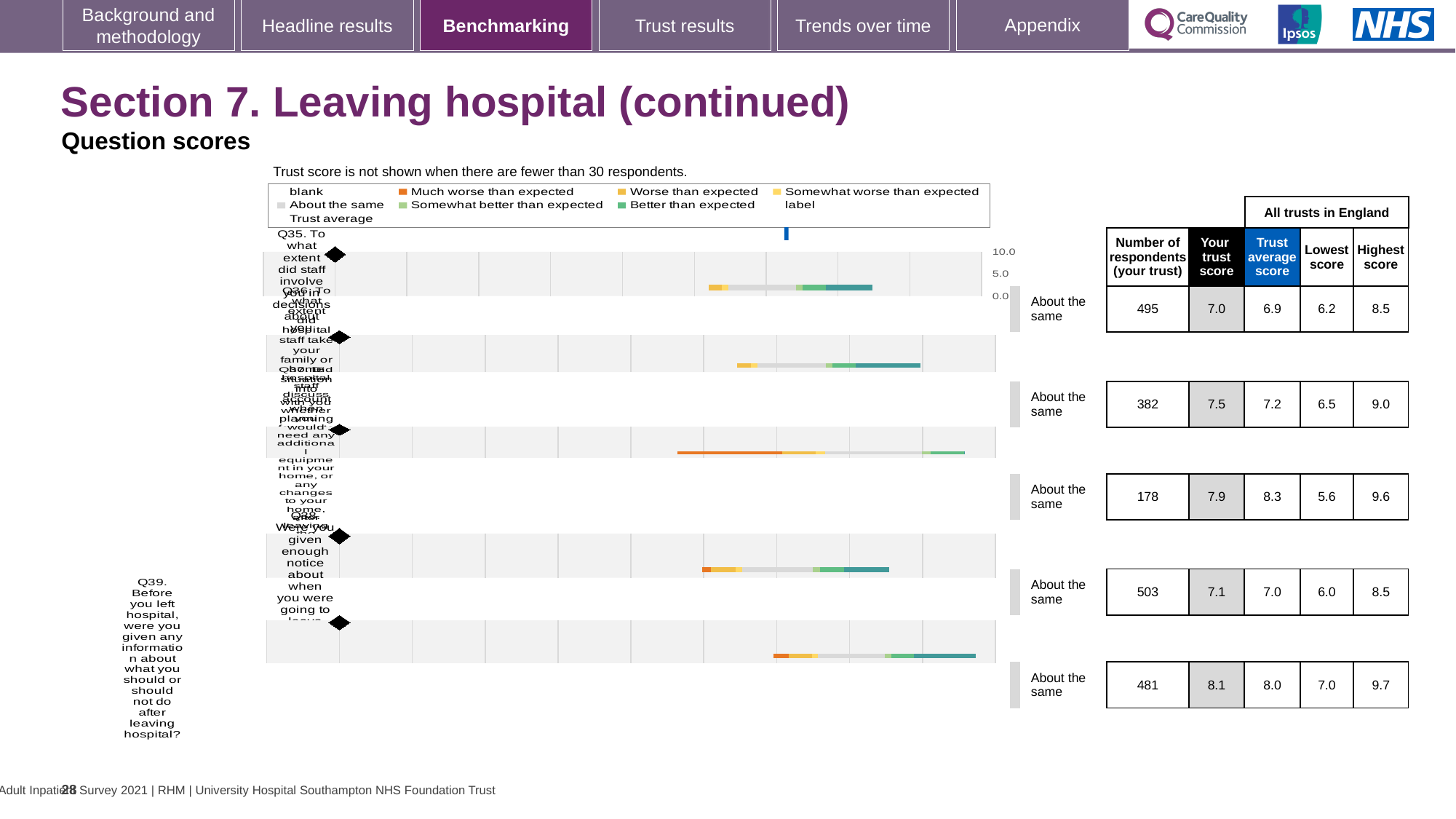
What is the trust score for Q35 (To what extent did staff involve you in decisions about you leaving hospital)? 7.0 What is the lowest score across all trusts in England for Q38? 6.0 What is the difference between the trust score and the trust average score for Q37? 0.4 What benchmark category is shown for Q38 (Were you given enough notice about when you were going to leave hospital)? About the same What is the number of respondents for Q39 (Before you left hospital, were you given any information about what you should or should not do after leaving hospital)? 481 What is the highest score across all trusts in England for Q36? 9.0 What kind of chart is used to show the question scores? Bar chart Which question has the fewest respondents for this trust? Q37 Which question has the highest trust score for this trust? Q39 How many questions are shown on the chart? 5 Which is larger for Q36: the trust score or the trust average score? Trust score What is the trust average score for Q37 (Did staff discuss with you whether you would need any additional equipment in your home)? 8.3